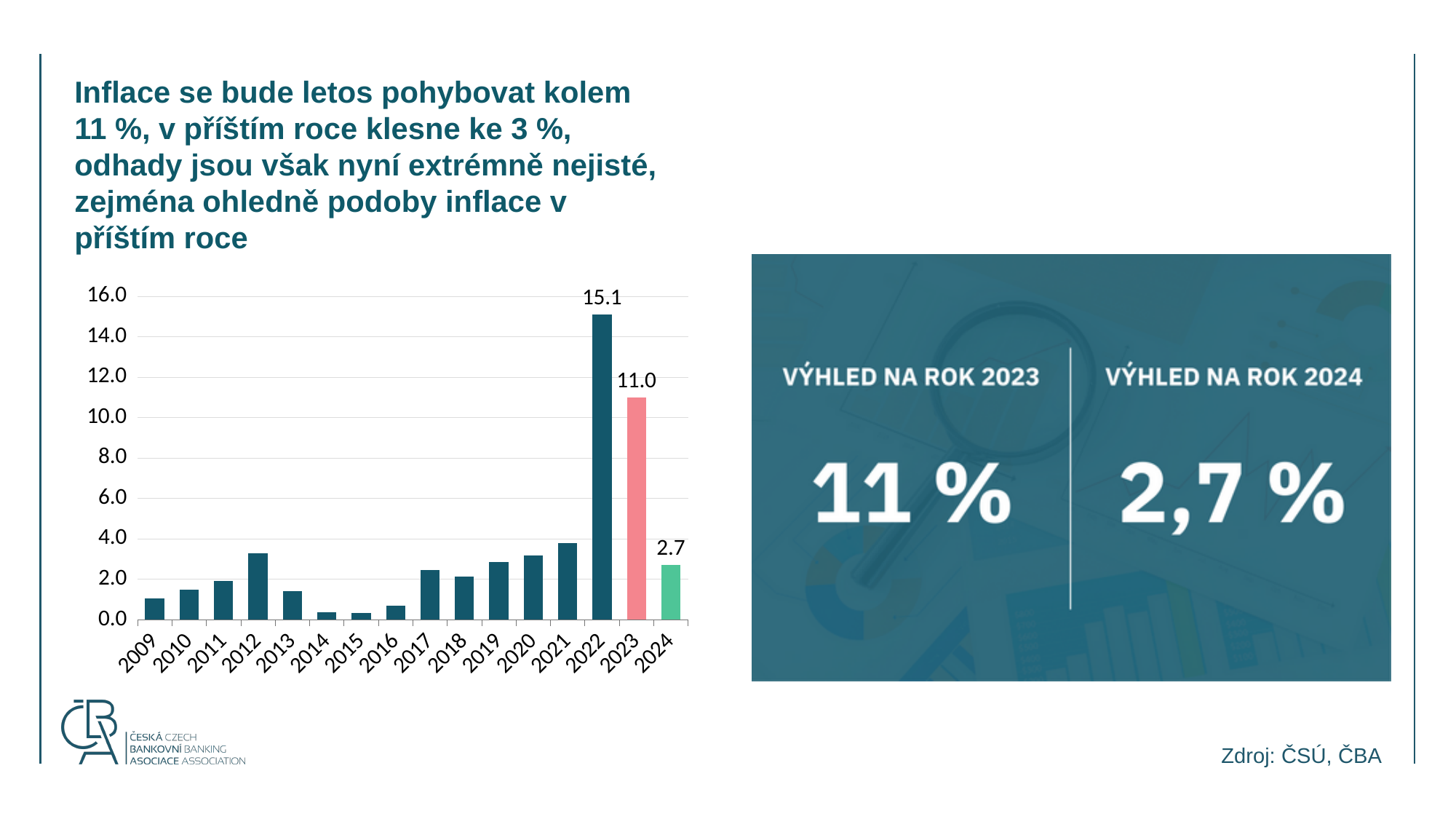
What kind of chart is shown on the slide? bar chart Is the value for 2021 greater or less than 2.0? greater Is the value for 2012 greater or less than 4.0? less Do the values rise or fall from 2016 to 2022? rise What is the difference between the values for 2023 and 2024? 8.3 What is the difference between the values for 2022 and 2023? 4.1 How many years are shown on the x axis of the chart? 16 What is the value shown for 2023? 11.0 What is the value shown for 2024? 2.7 What is the value shown for 2022? 15.1 Which is larger, the value for 2022 or the value for 2023? 2022 Which year has the highest bar? 2022